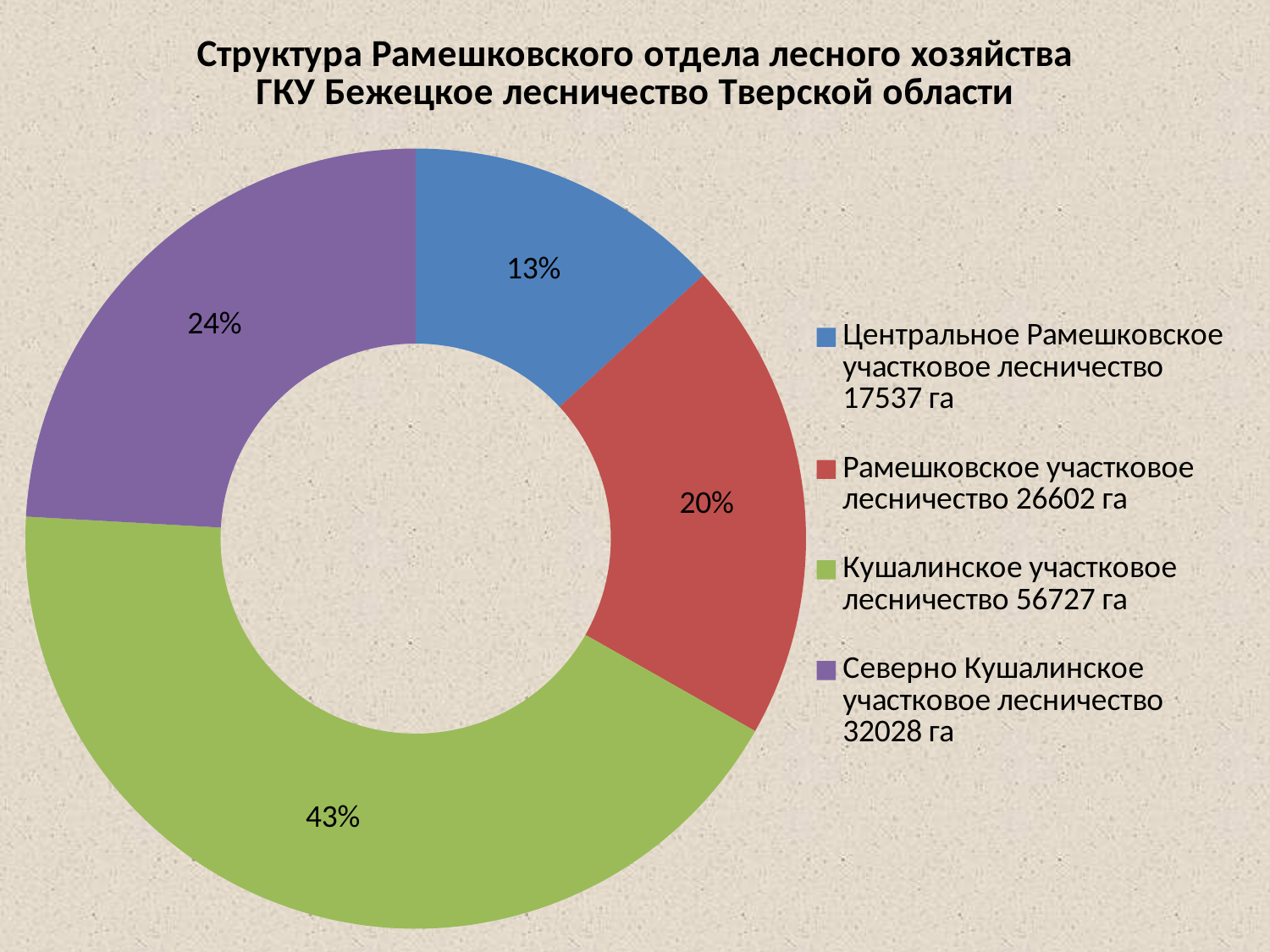
Which category has the largest share of the chart? Кушалинское участковое лесничество What percentage share is shown for Кушалинское участковое лесничество? 43% Which has a larger share: Рамешковское участковое лесничество or Северно Кушалинское участковое лесничество? Северно Кушалинское участковое лесничество Which category has the smallest share of the chart? Центральное Рамешковское участковое лесничество What colour represents Рамешковское участковое лесничество in the chart? Red What percentage share is shown for Северно Кушалинское участковое лесничество? 24% How many slices does the chart have? 4 What percentage share is shown for Центральное Рамешковское участковое лесничество? 13% What is the difference in percentage points between the shares of Кушалинское and Северно Кушалинское участковое лесничество? 19 percentage points According to the legend, what is the area in hectares of Кушалинское участковое лесничество? 56727 га What type of chart is shown on the slide? Doughnut (pie) chart